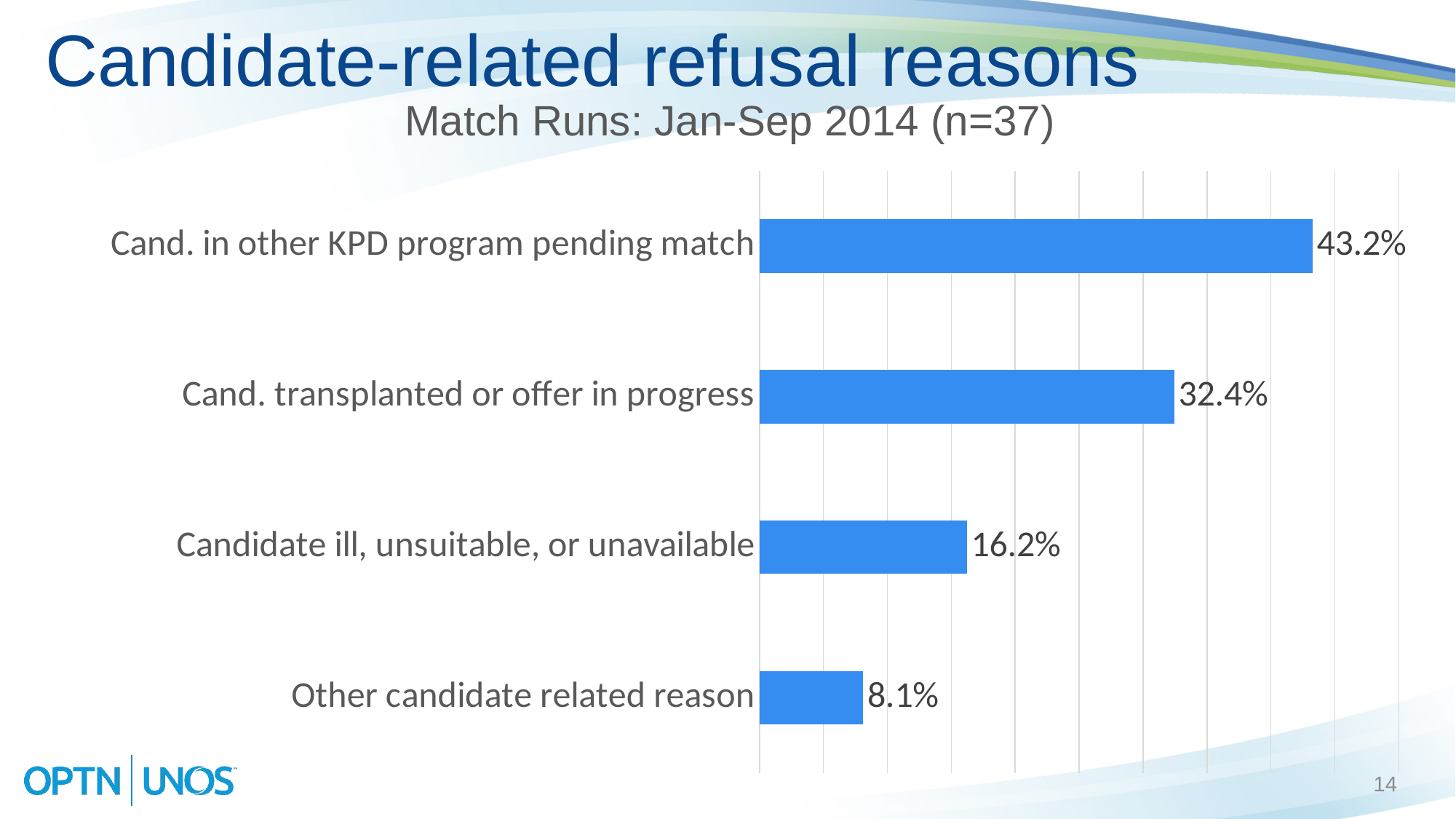
What is the value for "Other candidate related reason"? 8.1% What is the subtitle of the chart, including the sample size? Match Runs: Jan-Sep 2014 (n=37) What is the value for "Cand. in other KPD program pending match"? 43.2% What is the difference between "Candidate ill, unsuitable, or unavailable" and "Other candidate related reason"? 8.1% Which refusal reason has the highest value? Cand. in other KPD program pending match How many refusal reasons are shown in the chart? 4 Which refusal reason has the lowest value? Other candidate related reason What is the value for "Candidate ill, unsuitable, or unavailable"? 16.2% What kind of chart is shown on the slide? Bar chart What is the difference between "Cand. in other KPD program pending match" and "Cand. transplanted or offer in progress"? 10.8% What is the value for "Cand. transplanted or offer in progress"? 32.4% Which is larger: "Cand. transplanted or offer in progress" or "Candidate ill, unsuitable, or unavailable"? Cand. transplanted or offer in progress